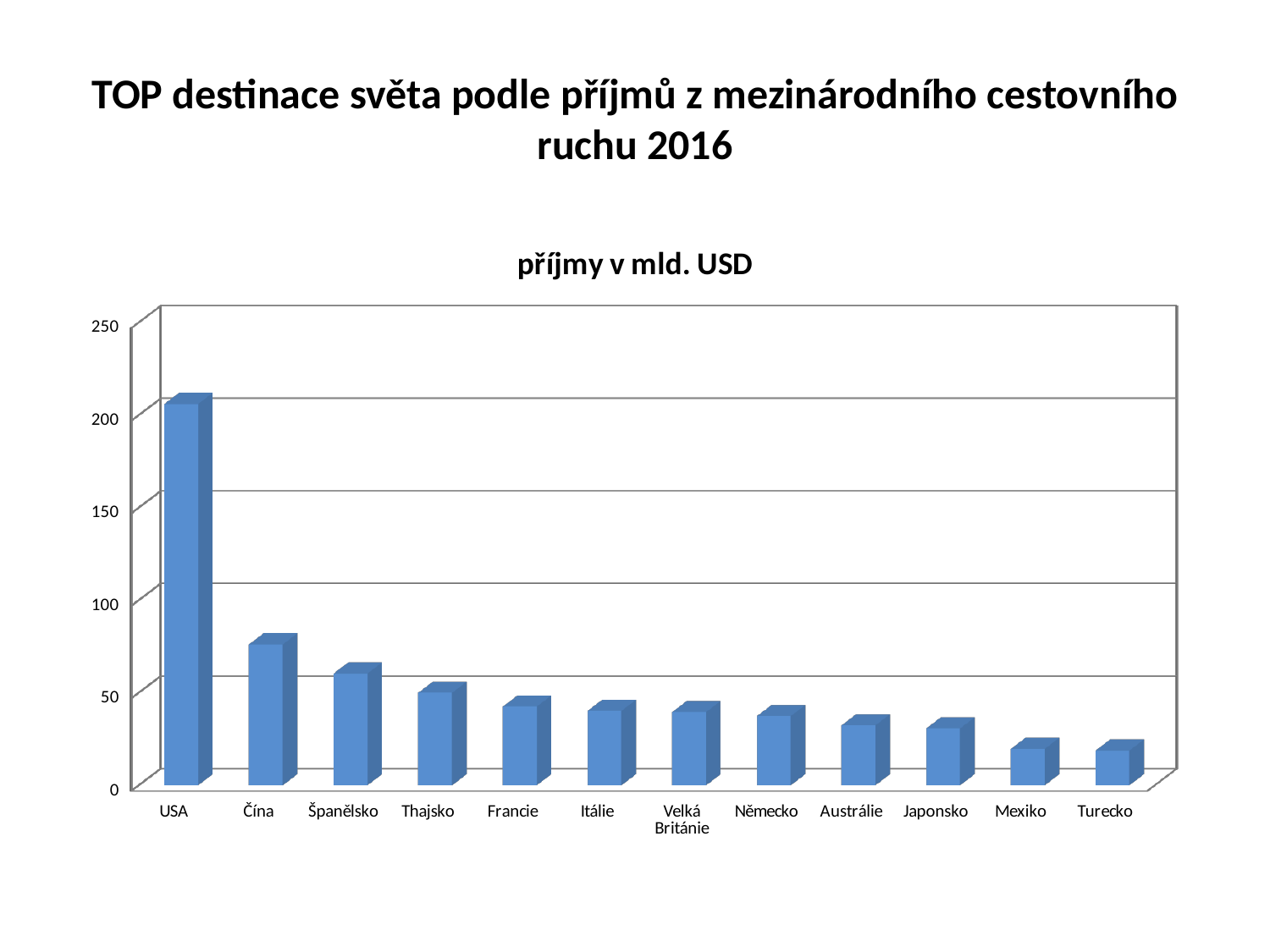
Is the value for Francie greater or less than 50? less Is the value for Čína greater or less than 50? greater Do the values rise or fall from left to right along the x axis? fall Which is larger, the value for USA or the value for Čína? USA What is the title shown above the chart's plot area? příjmy v mld. USD Is the value for USA greater or less than 200? greater Which country has the highest value in the chart? USA What kind of chart is shown on the slide? bar chart Which is larger, the value for Španělsko or the value for Turecko? Španělsko How many countries are shown on the x axis of the chart? 12